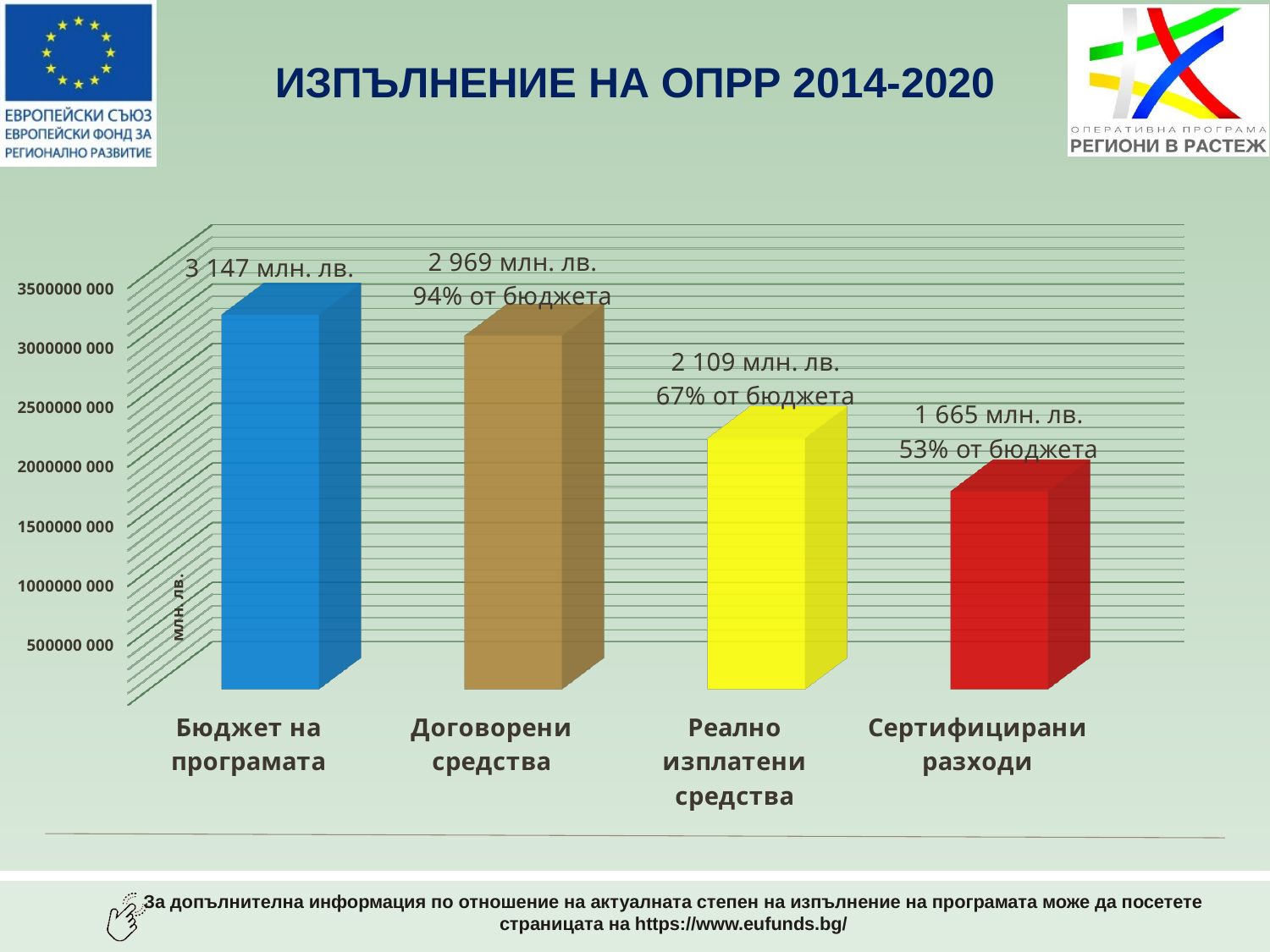
What is the difference between Реално изплатени средства and Сертифицирани разходи, in млн. лв.? 444 млн. лв. Which category has the highest value? Бюджет на програмата What value is labelled on the bar for Договорени средства? 2 969 млн. лв. What percentage of the budget do Сертифицирани разходи represent, according to the data label? 53% от бюджета How many categories are shown on the chart? 4 What value is labelled on the bar for Бюджет на програмата? 3 147 млн. лв. Which is larger: Договорени средства or Реално изплатени средства? Договорени средства What value is labelled on the bar for Реално изплатени средства? 2 109 млн. лв. What is the difference between Бюджет на програмата and Договорени средства, in млн. лв.? 178 млн. лв. What kind of chart is shown on the slide? Bar chart Which category has the lowest value? Сертифицирани разходи Do the values rise or fall from left to right across the categories? Fall